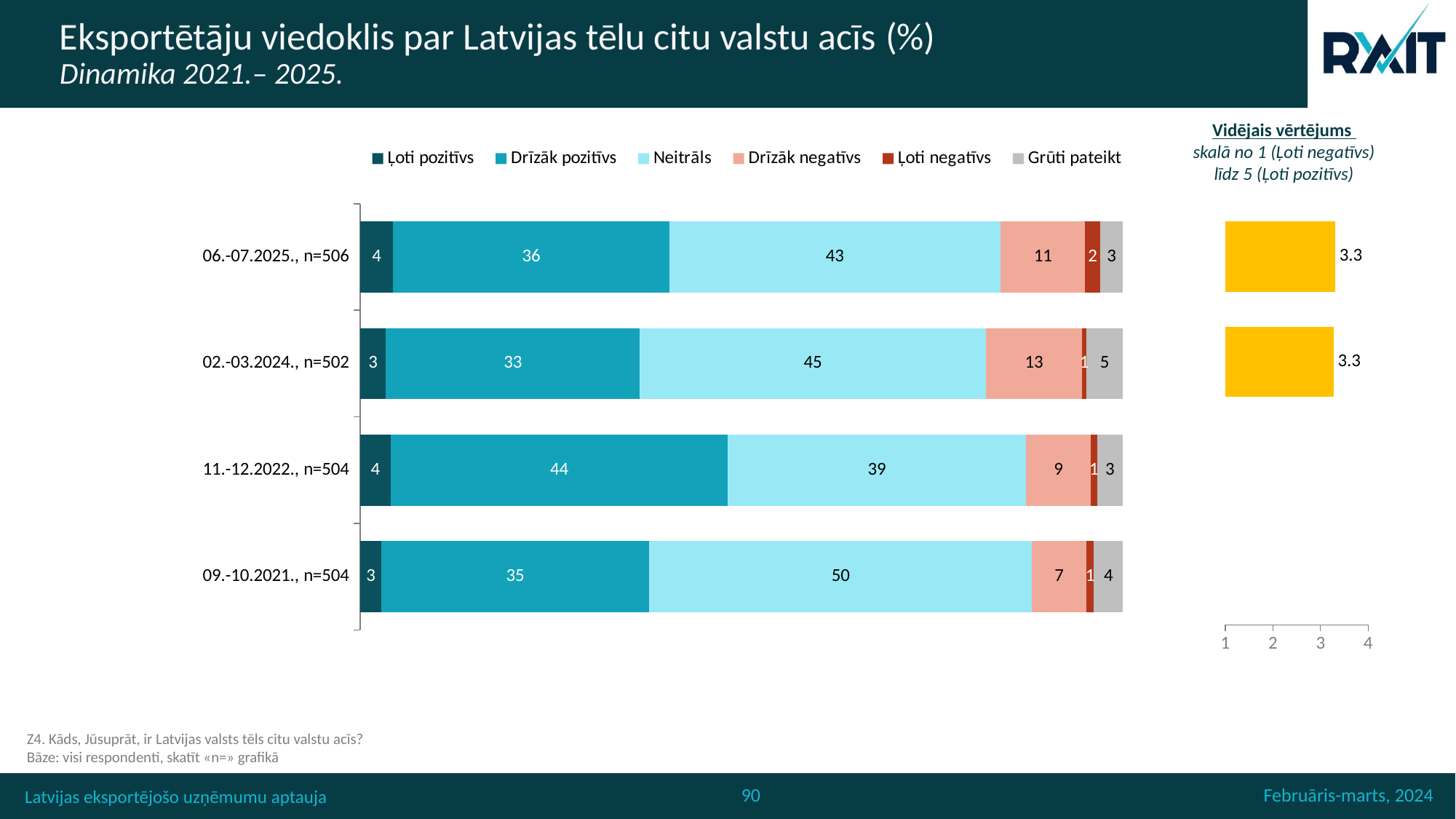
What kind of chart is the main chart on the slide? Stacked bar chart In the main stacked bar chart, which wave has the larger Drīzāk pozitīvs value: 02.-03.2024., n=502 or 06.-07.2025., n=506? 06.-07.2025., n=506 How many series does the legend of the main chart list? 6 In the main stacked bar chart, which survey wave has the lowest Drīzāk negatīvs value? 09.-10.2021., n=504 In the main stacked bar chart, what is the value for Drīzāk negatīvs in the 02.-03.2024., n=502 wave? 13 How many survey waves are shown in the main stacked bar chart? 4 In the main stacked bar chart, what is the difference between the Neitrāls value for 09.-10.2021., n=504 and for 06.-07.2025., n=506? 7 In the main stacked bar chart, which survey wave has the highest Neitrāls value? 09.-10.2021., n=504 In the main stacked bar chart, what is the total of all segments for the 02.-03.2024., n=502 bar? 100 In the main stacked bar chart, what is the value for Drīzāk pozitīvs in the 11.-12.2022., n=504 wave? 44 In the Vidējais vērtējums chart on the right, what is the average rating for the 02.-03.2024., n=502 wave? 3.3 In the main stacked bar chart, what is the value for Neitrāls in the 06.-07.2025., n=506 wave? 43